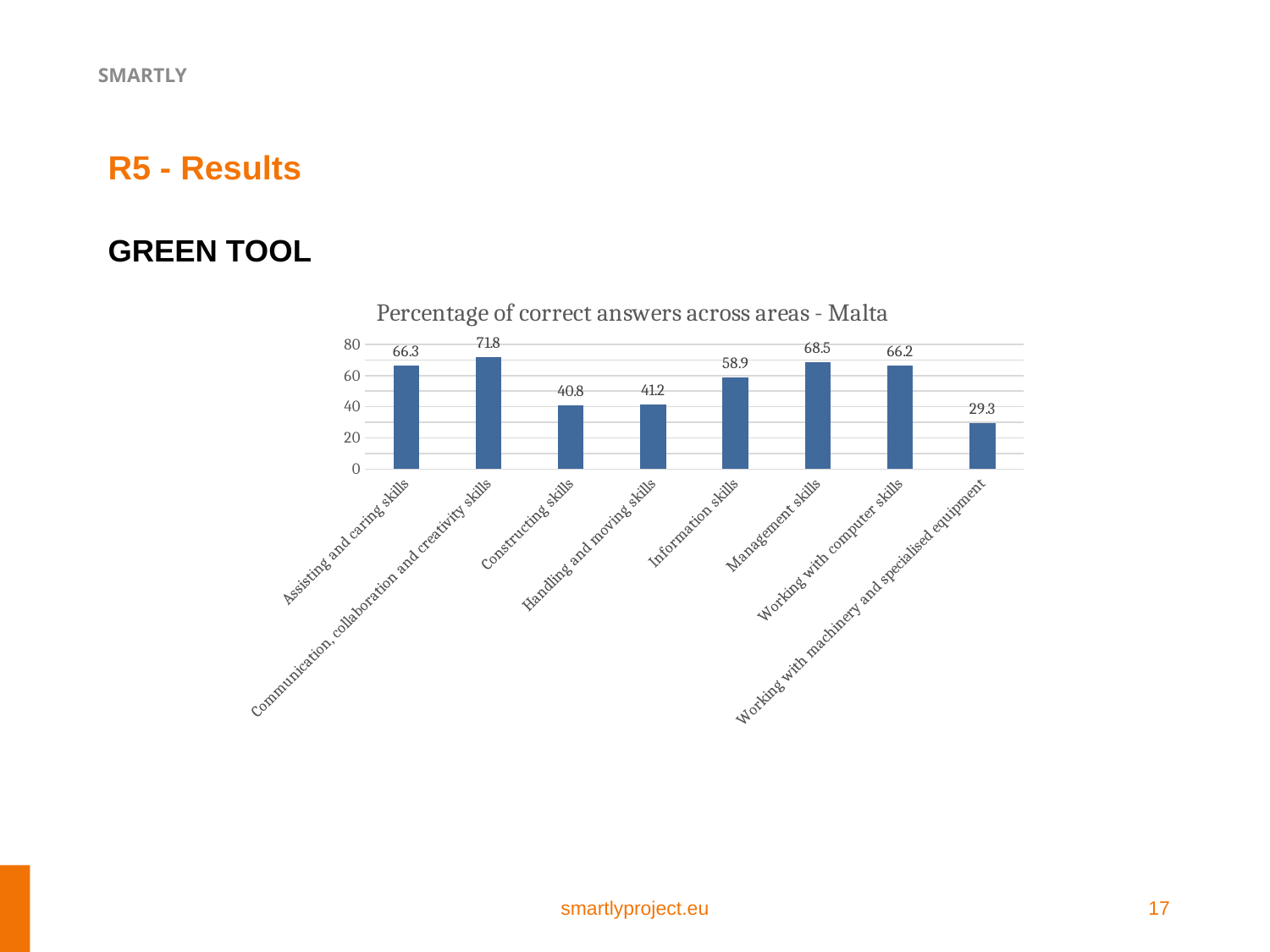
Which category has the highest percentage of correct answers? Communication, collaboration and creativity skills What kind of chart is shown on the slide? bar chart How many categories are shown in the chart? 8 Which is larger, the value for Information skills or the value for Working with computer skills? Working with computer skills What is the value for Assisting and caring skills? 66.3 What is the title of the chart? Percentage of correct answers across areas - Malta What is the difference between the values for Communication, collaboration and creativity skills and Working with machinery and specialised equipment? 42.5 What is the value for Working with machinery and specialised equipment? 29.3 What is the value for Information skills? 58.9 What is the difference between the values for Management skills and Constructing skills? 27.7 Which category has the lowest percentage of correct answers? Working with machinery and specialised equipment Is the value for Handling and moving skills greater or less than 60? less